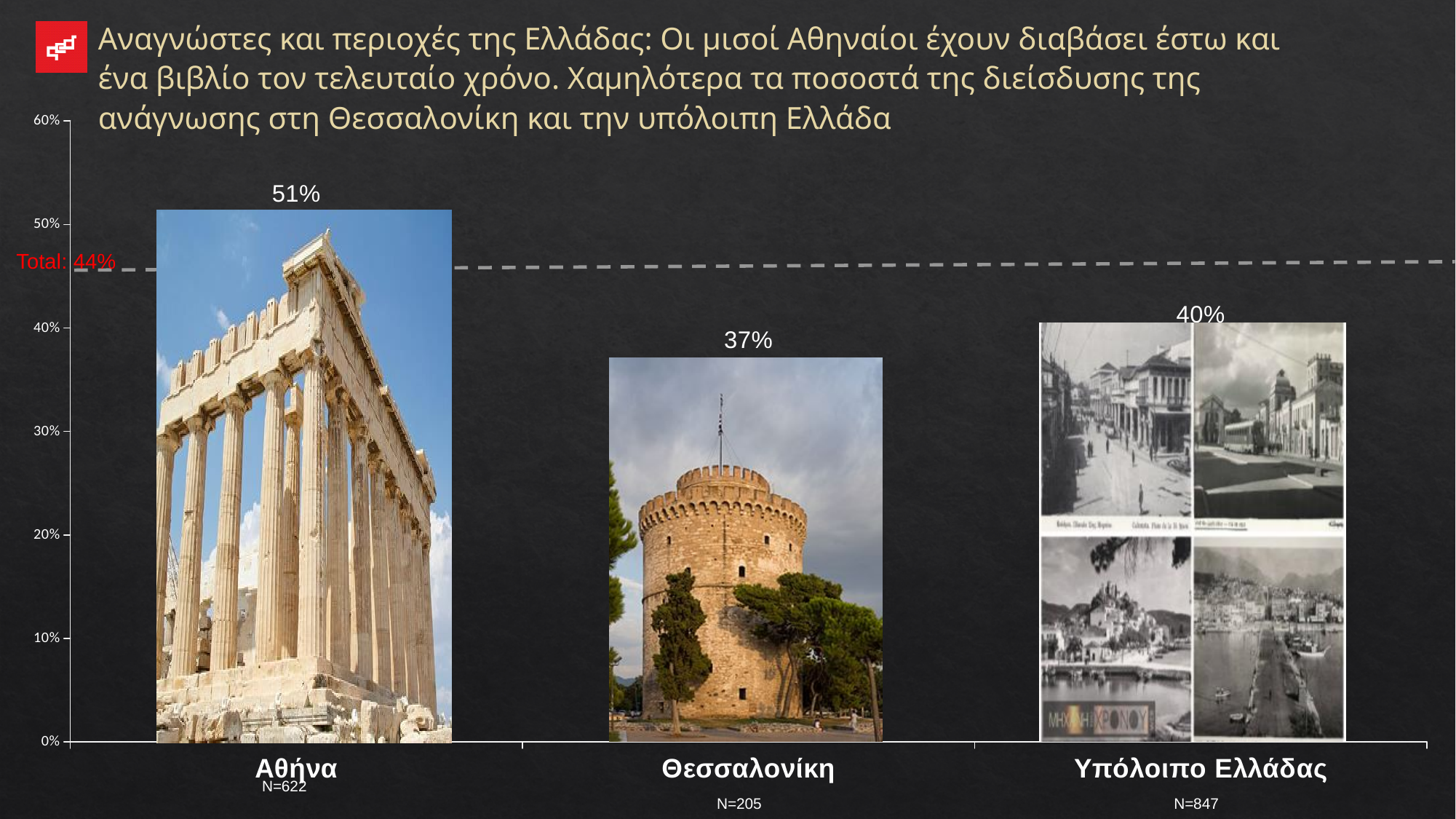
What total value is marked by the dashed line on the chart? 44% Which category has the lowest value? Θεσσαλονίκη What kind of chart is shown on the slide? bar chart What is the value for Θεσσαλονίκη? 37% Is the value for Θεσσαλονίκη greater or less than 40%? less Which is larger, the value for Αθήνα or the value for Υπόλοιπο Ελλάδας? Αθήνα What is the value for Αθήνα? 51% What is the difference between the values for Αθήνα and Θεσσαλονίκη? 14% How many categories are shown on the chart? 3 Which category has the highest value? Αθήνα What is the difference between the values for Υπόλοιπο Ελλάδας and Θεσσαλονίκη? 3% What is the value for Υπόλοιπο Ελλάδας? 40%